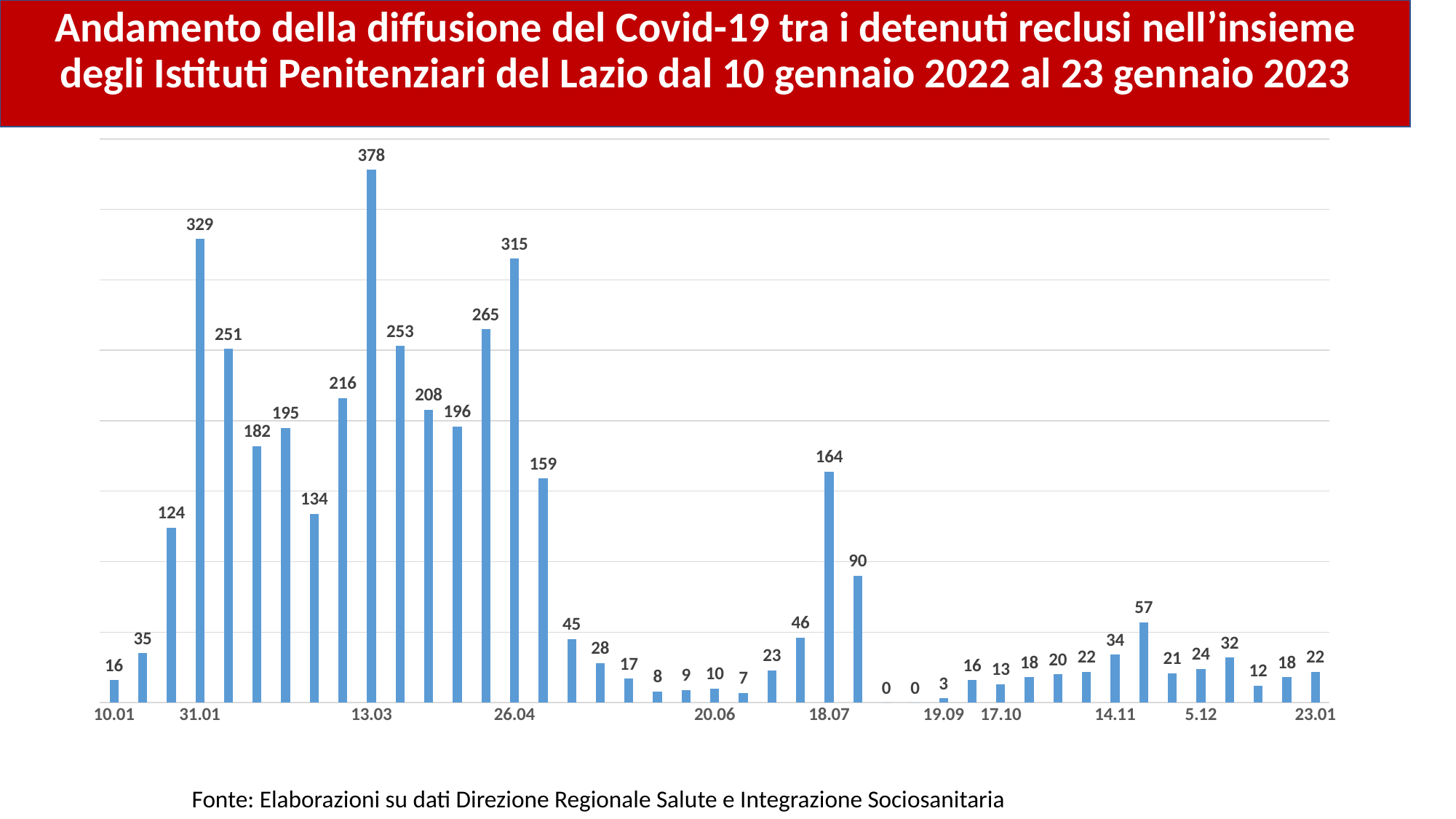
Which is larger, the bar labelled 31.01 or the bar labelled 26.04? 31.01 What is the value of the bar labelled 18.07? 164 What is the highest value shown in the chart? 378 What is the value of the bar labelled 31.01? 329 What is the difference between the bar labelled 13.03 and the bar labelled 31.01? 49 What type of chart is shown on the slide? Bar chart What is the lowest value shown in the chart? 0 How many bars are plotted in the chart? 43 What is the value of the bar labelled 13.03? 378 What is the value of the last bar, labelled 23.01? 22 What is the value of the first bar, labelled 10.01? 16 What source is cited below the chart? Elaborazioni su dati Direzione Regionale Salute e Integrazione Sociosanitaria